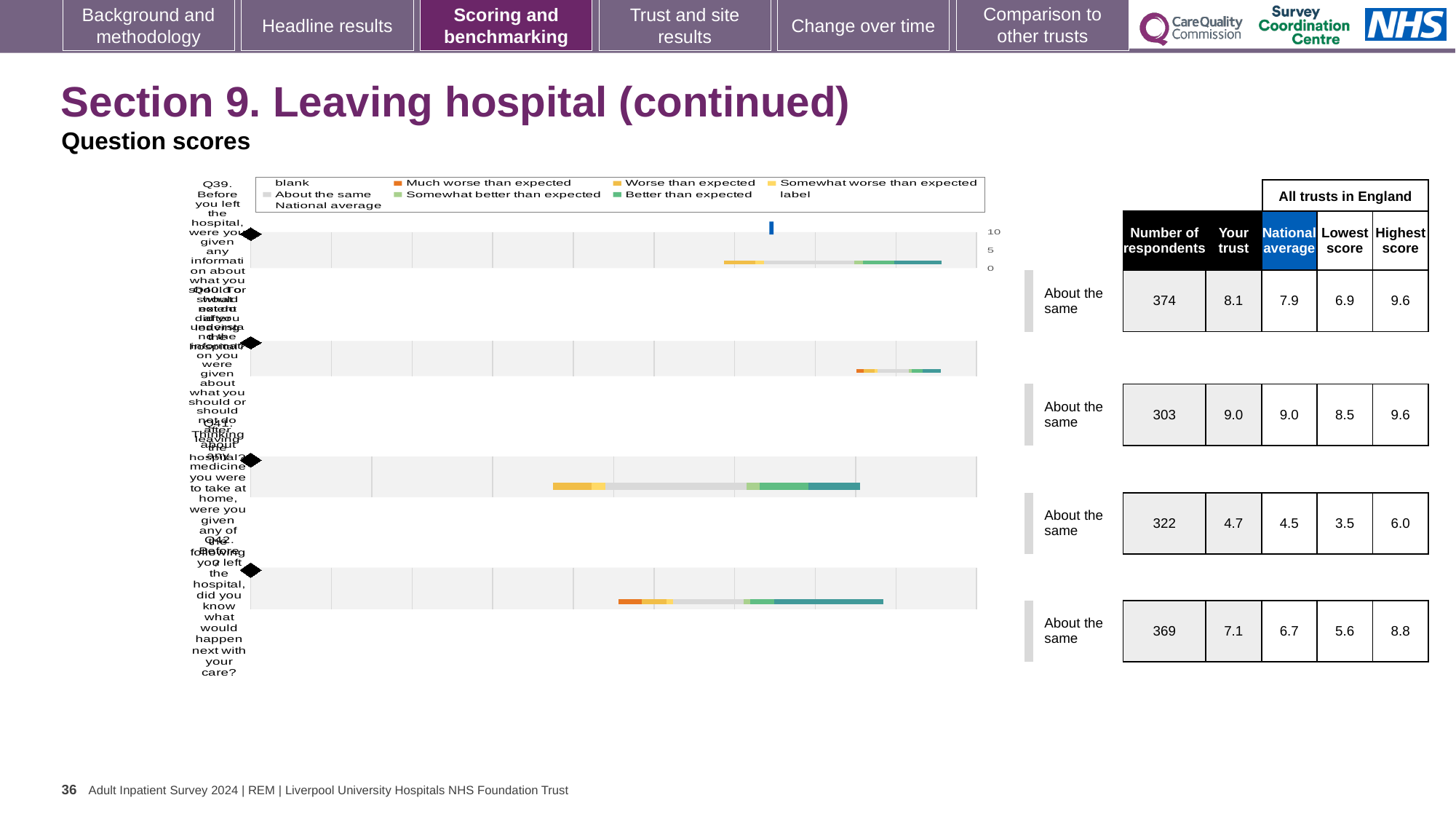
How many separate question charts are shown on the slide? 4 Which legend entry is shown in orange? Much worse than expected Which question number does the bottom chart on the slide relate to? Q42 What is the highest tick value shown on the horizontal axis of the top chart? 10 Which question number does the top chart on the slide relate to? Q39 What kind of chart is used to show the question scores on this slide? bar chart